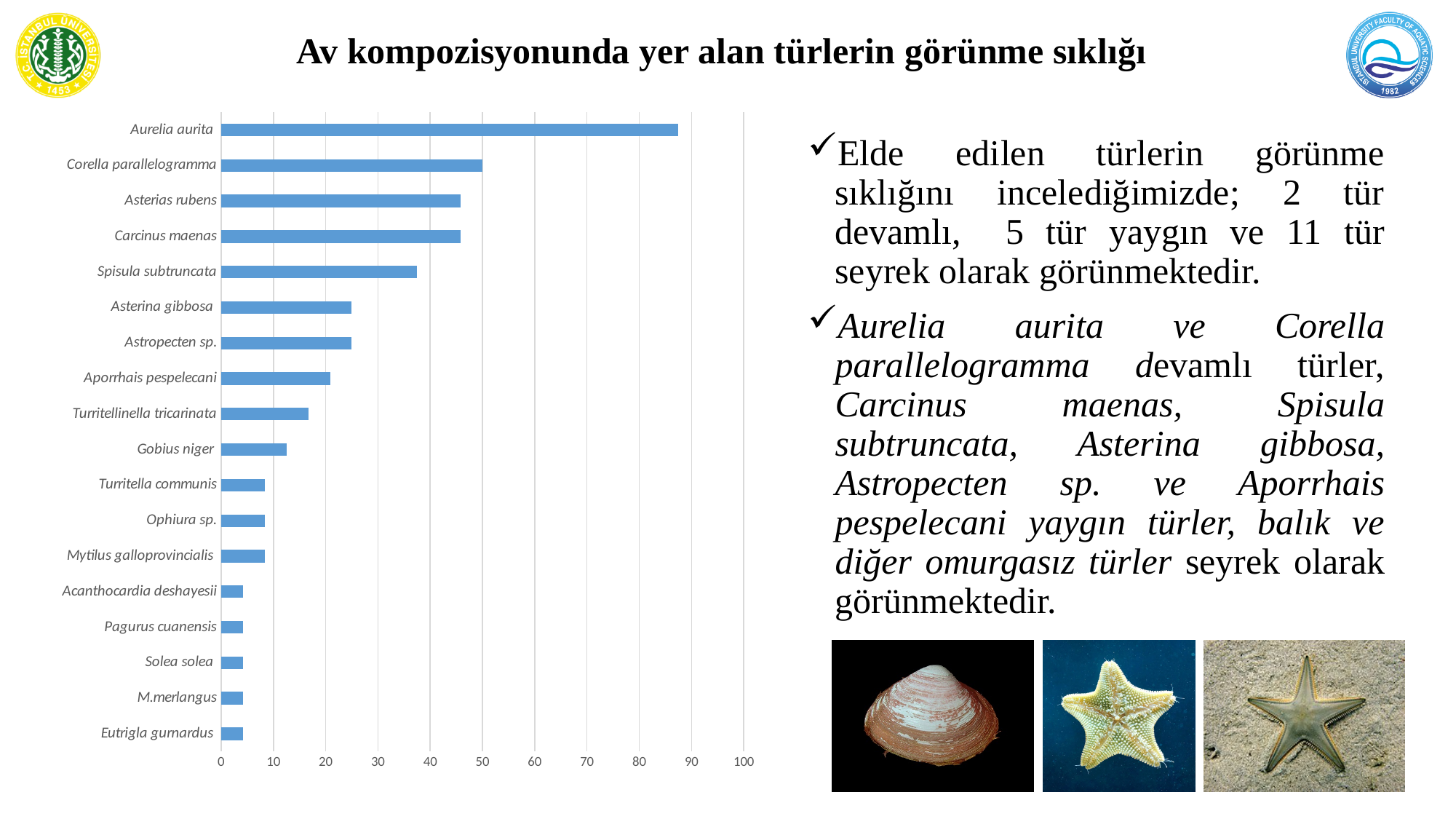
Is the value for Aurelia aurita greater or less than 80? greater What is the title of the slide containing the chart? Av kompozisyonunda yer alan türlerin görünme sıklığı What kind of chart is shown on the slide? bar chart How many species (categories) are plotted in the chart? 18 Which species has the highest value in the chart? Aurelia aurita Is the value for Eutrigla gurnardus greater or less than 10? less Is the value for Spisula subtruncata greater or less than 30? greater Which has a larger value, Turritellinella tricarinata or Gobius niger? Turritellinella tricarinata Which has a larger value, Aurelia aurita or Corella parallelogramma? Aurelia aurita Which has a larger value, Spisula subtruncata or Asterina gibbosa? Spisula subtruncata